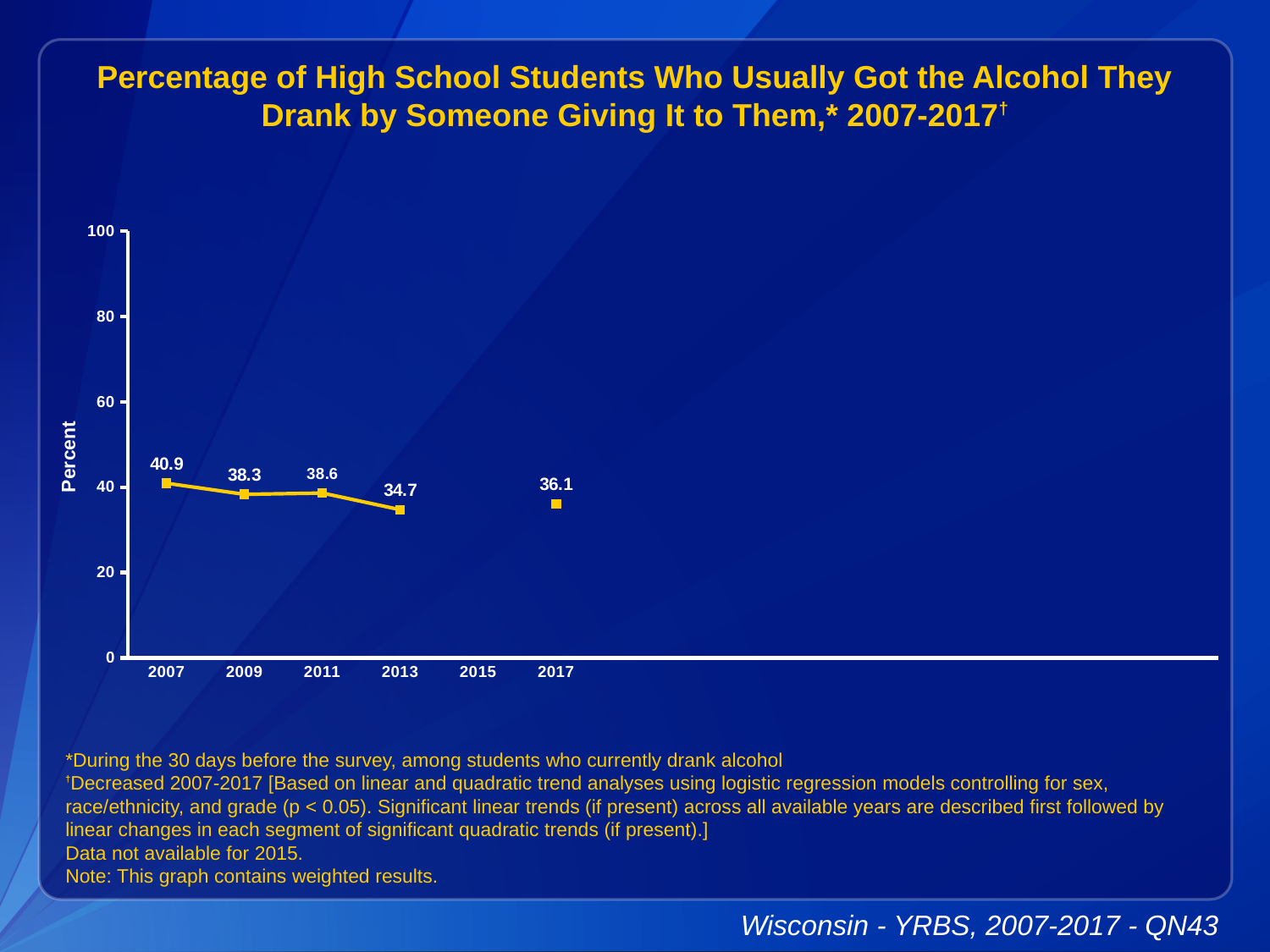
What kind of chart is shown on the slide? line chart How many years have data points plotted on the chart? 5 What is the label on the y axis? Percent What value is shown for 2013? 34.7 Which year has the lowest value on the chart? 2013 Is the value for 2017 greater or less than 40? less Which year has the highest value on the chart? 2007 Which year has the larger value, 2009 or 2011? 2011 What is the difference between the 2007 value and the 2013 value? 6.2 What value is shown for 2017? 36.1 Did the values generally rise or fall from 2007 to 2013? fall What was the percentage of high school students who usually got the alcohol they drank by someone giving it to them in 2007? 40.9